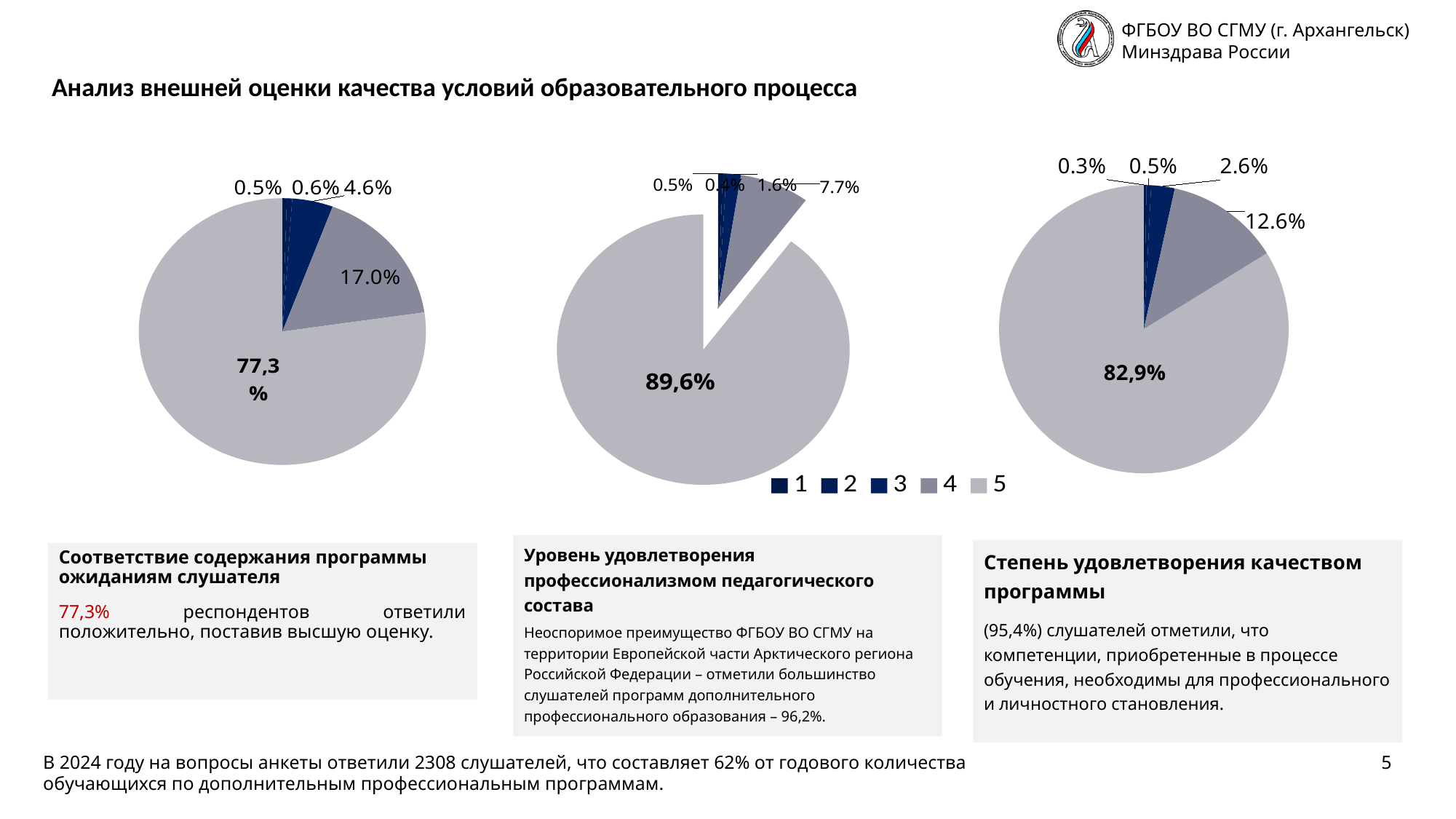
In the middle pie chart, what share is shown for category 4? 7.7% What type of charts are shown on the slide? Pie charts What is the difference between the category 5 share in the middle pie chart and in the right pie chart? 6,7% In the left pie chart, what share is shown for category 5? 77,3% What is the smallest percentage labelled on the right pie chart? 0.3% How many entries does the legend list? 5 In the right pie chart, what share is shown for category 4? 12.6% In the right pie chart, what share is shown for category 5? 82,9% How many pie charts are on the slide? 3 Which chart has the larger share for category 4, the left pie chart or the right pie chart? The left pie chart In the middle pie chart, what is the share of the largest slice? 89,6% In the left pie chart, what share is shown for category 4? 17.0%